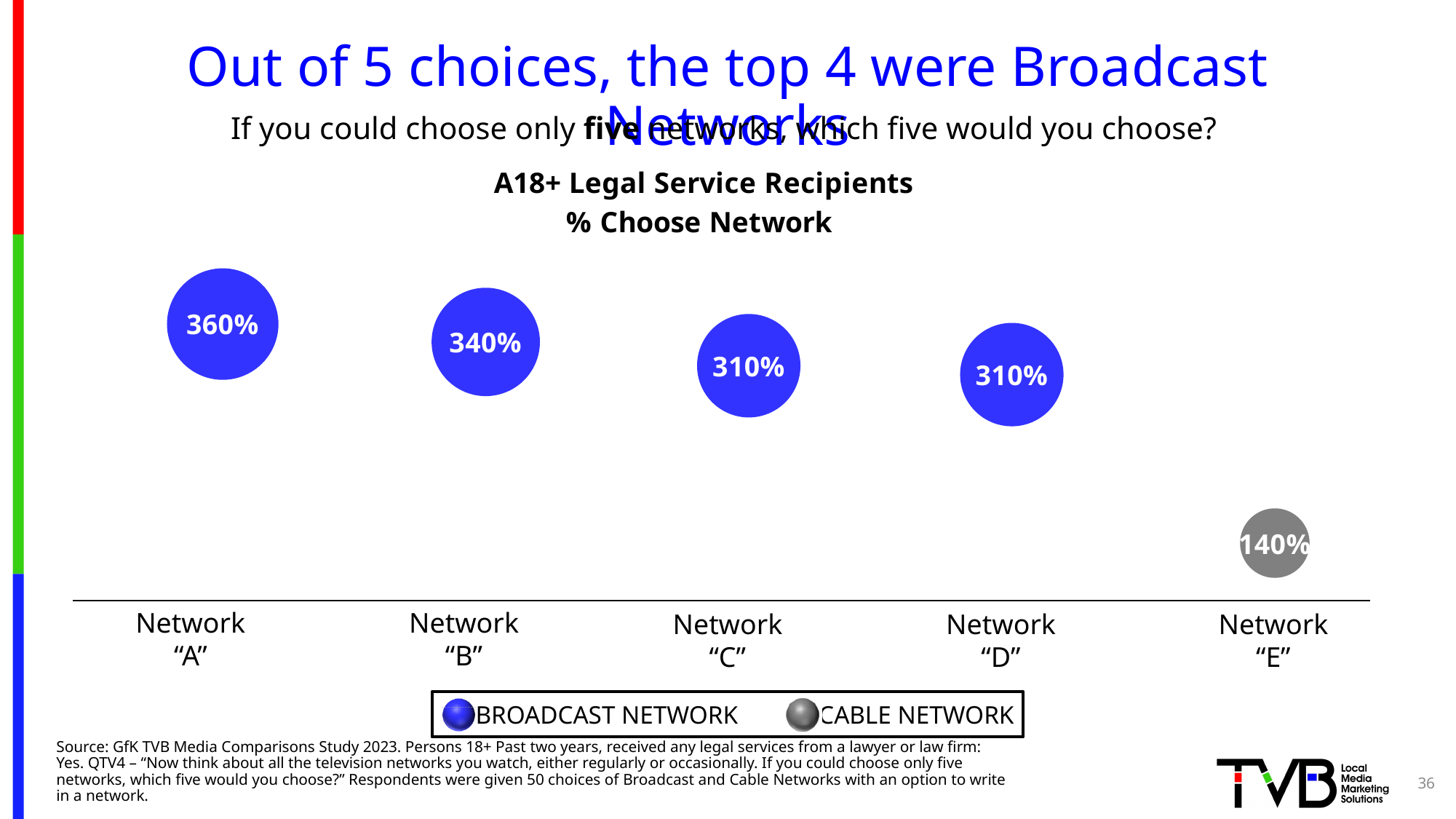
What is the value for Network "B"? 340% Which network has the lowest value? Network "E" What is the difference between the values for Network "B" and Network "C"? 30% Which is larger, the value for Network "B" or Network "D"? Network "B" Which network is shown as a Cable Network? Network "E" Which network has the highest value? Network "A" How many networks are shown in the chart? 5 What kind of chart is shown on the slide? Bubble chart How many series does the legend list? 2 What is the difference between the values for Network "A" and Network "E"? 220% What is the value for Network "E"? 140% What is the value for Network "A"? 360%